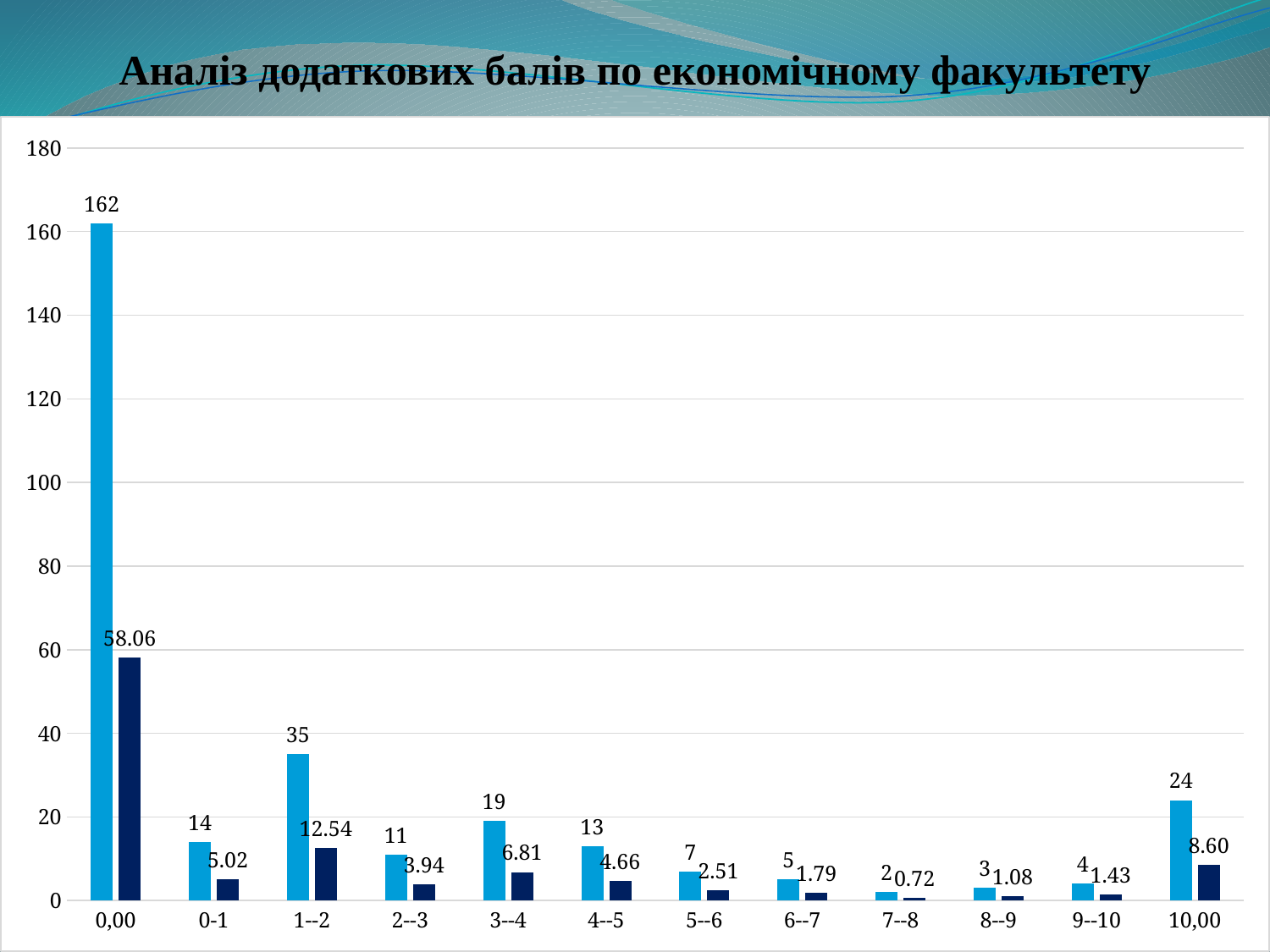
Which is larger, the light blue bar for 4--5 or the light blue bar for 10,00? 10,00 How many categories are shown on the x axis? 12 What is the value of the light blue bar for the category 0,00? 162 What is the difference between the light blue bars for 1--2 and 3--4? 16 What is the value of the light blue bar for the category 10,00? 24 Which category has the highest light blue bar? 0,00 What is the title of the slide? Аналіз додаткових балів по економічному факультету What is the value of the dark blue bar for the category 7--8? 0.72 What is the value of the dark blue bar for the category 1--2? 12.54 Which category has the lowest dark blue bar? 7--8 What kind of chart is shown on the slide? bar chart Is the dark blue bar for 0,00 greater or less than 60? less